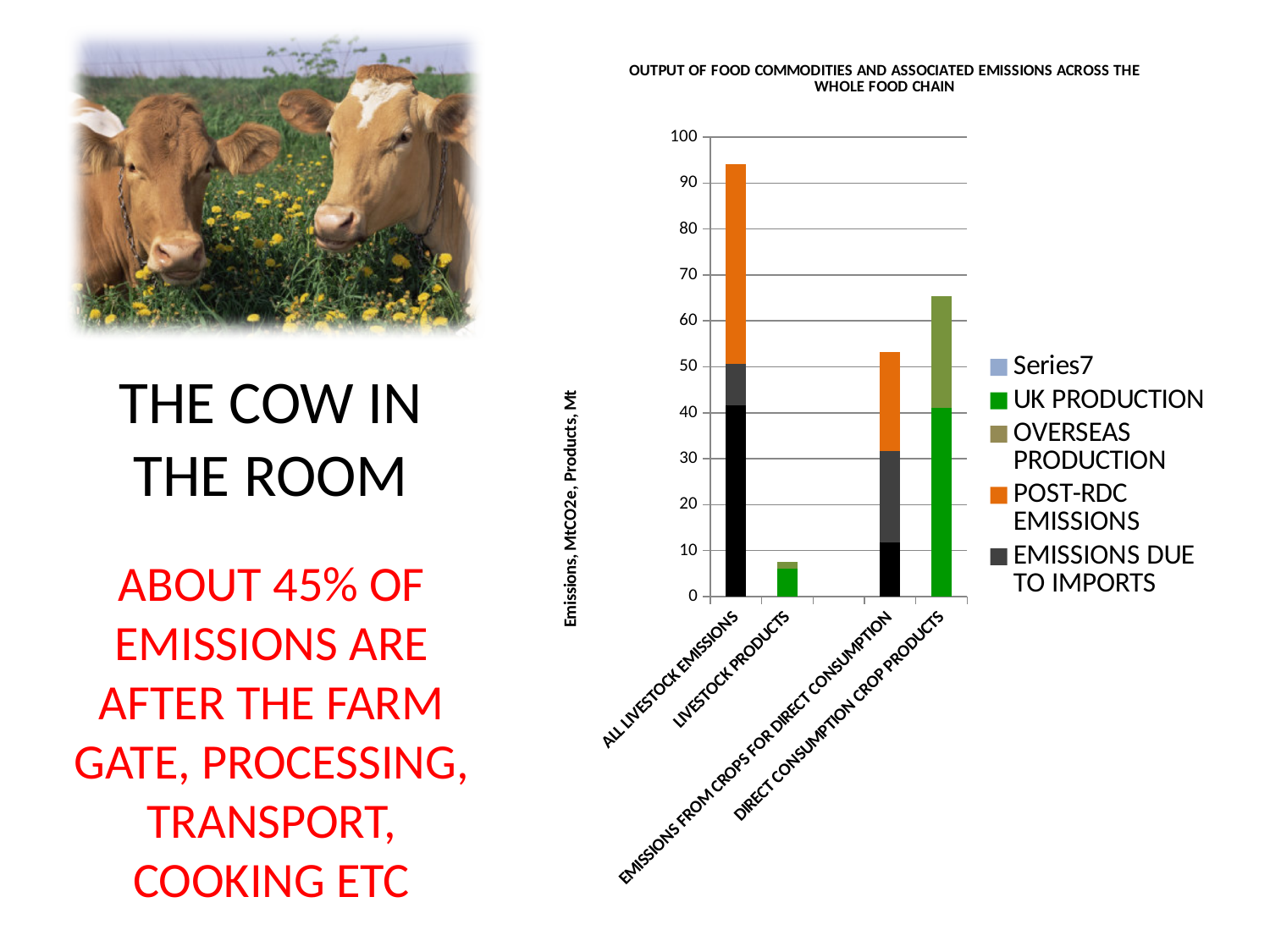
Is the total bar height for DIRECT CONSUMPTION CROP PRODUCTS greater or less than 70? less What is the title of the chart? OUTPUT OF FOOD COMMODITIES AND ASSOCIATED EMISSIONS ACROSS THE WHOLE FOOD CHAIN Is the total bar height for EMISSIONS FROM CROPS FOR DIRECT CONSUMPTION greater or less than 50? greater What kind of chart is shown on the slide? Stacked bar chart What is the label on the vertical axis of the chart? Emissions, MtCO2e, Products, Mt Is the total bar height for ALL LIVESTOCK EMISSIONS greater or less than 90? greater How many entries does the chart's legend list? 5 Which category has the tallest stacked bar? ALL LIVESTOCK EMISSIONS Which category has the shortest stacked bar? LIVESTOCK PRODUCTS How many categories are shown on the x axis of the chart? 4 Which bar is taller: DIRECT CONSUMPTION CROP PRODUCTS or EMISSIONS FROM CROPS FOR DIRECT CONSUMPTION? DIRECT CONSUMPTION CROP PRODUCTS